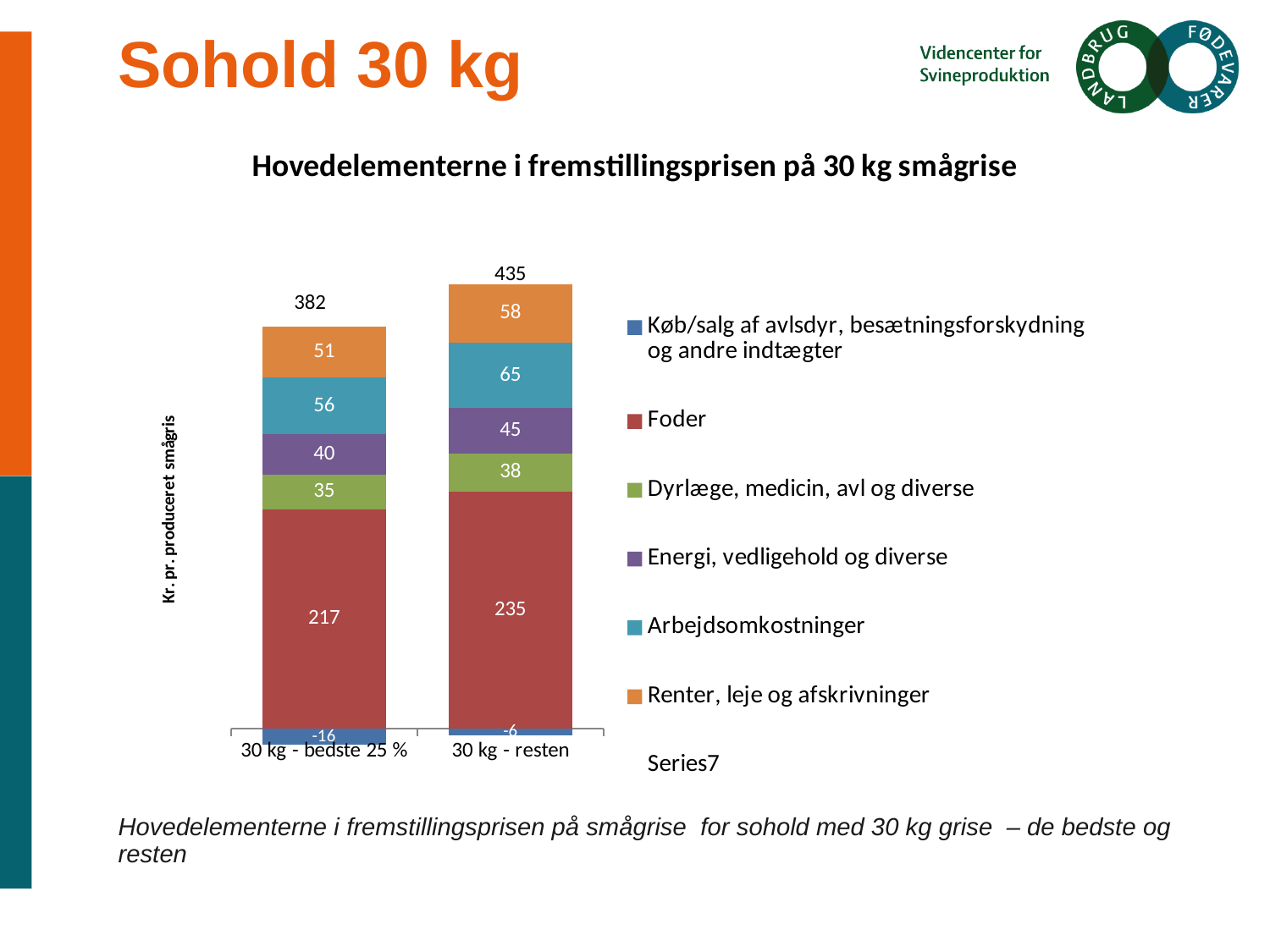
What is the value for Køb/salg af avlsdyr, besætningsforskydning og andre indtægter for "30 kg - bedste 25 %"? -16 What is the title of the chart? Hovedelementerne i fremstillingsprisen på 30 kg smågrise What is the total shown above the "30 kg - resten" bar? 435 Which category has the higher Renter, leje og afskrivninger value? 30 kg - resten What is the total shown above the "30 kg - bedste 25 %" bar? 382 What is the difference between the Foder values for "30 kg - resten" and "30 kg - bedste 25 %"? 18 What kind of chart is shown on the slide? Stacked bar chart What is the Arbejdsomkostninger value for "30 kg - resten"? 65 What is the Foder value for "30 kg - resten"? 235 How many entries does the legend list? 7 What is the Foder value for "30 kg - bedste 25 %"? 217 How many categories are shown on the x axis? 2